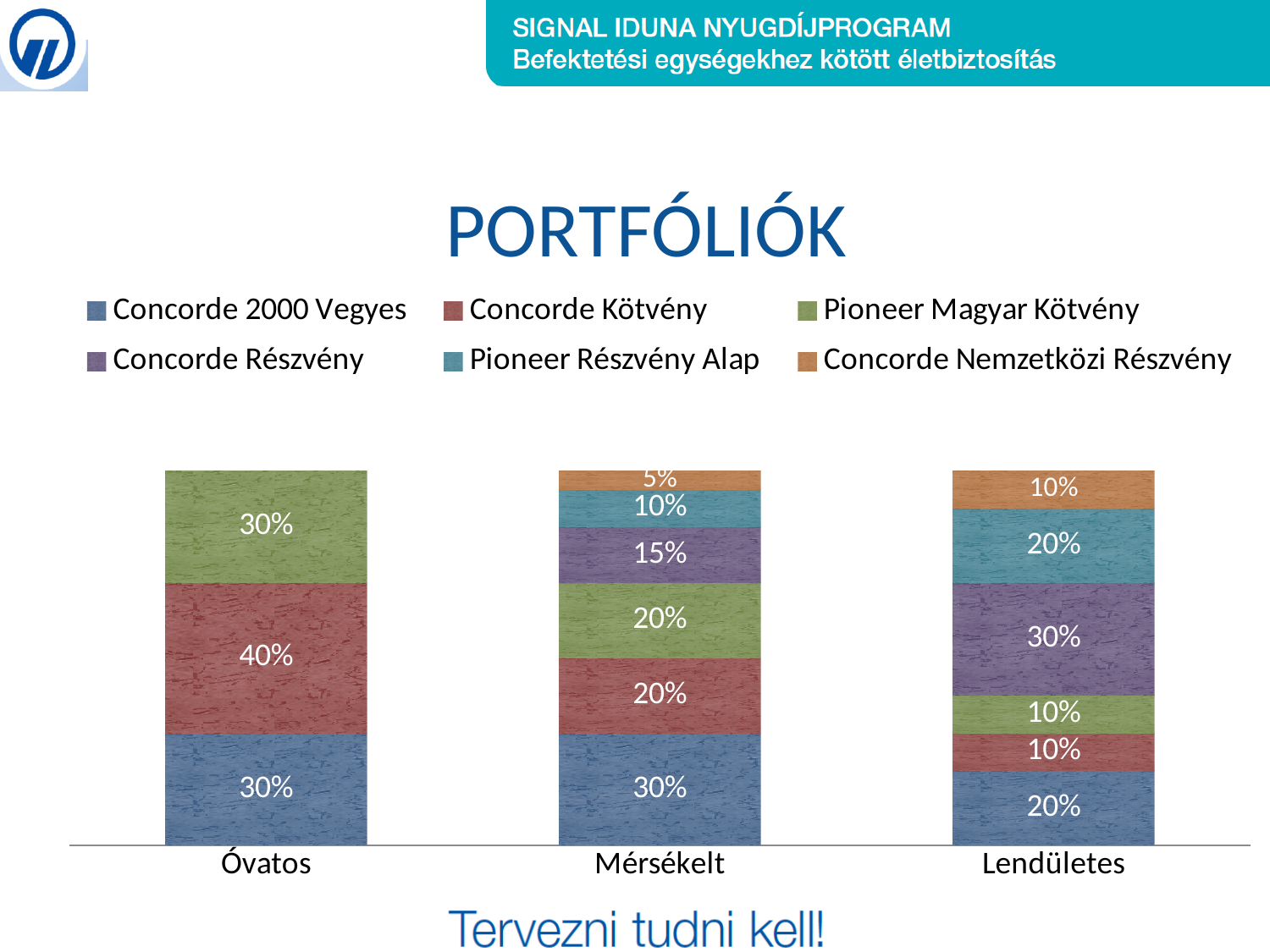
How many series does the legend list? 6 Which series has the smallest share in the Mérsékelt portfolio? Concorde Nemzetközi Részvény What is the value for Pioneer Részvény Alap in the Lendületes portfolio? 20% What is the value for Concorde Részvény in the Lendületes portfolio? 30% What is the difference between the Concorde Kötvény value in Óvatos and in Lendületes? 30% What kind of chart is shown on the slide? Stacked bar chart Which series has the largest share in the Óvatos portfolio? Concorde Kötvény What is the value for Concorde 2000 Vegyes in the Mérsékelt portfolio? 30% Which is larger: Concorde Részvény in Mérsékelt or Concorde Részvény in Lendületes? Concorde Részvény in Lendületes How many portfolio categories are shown on the x axis? 3 What is the value for Concorde Kötvény in the Óvatos portfolio? 40% What is the value for Concorde Nemzetközi Részvény in the Mérsékelt portfolio? 5%